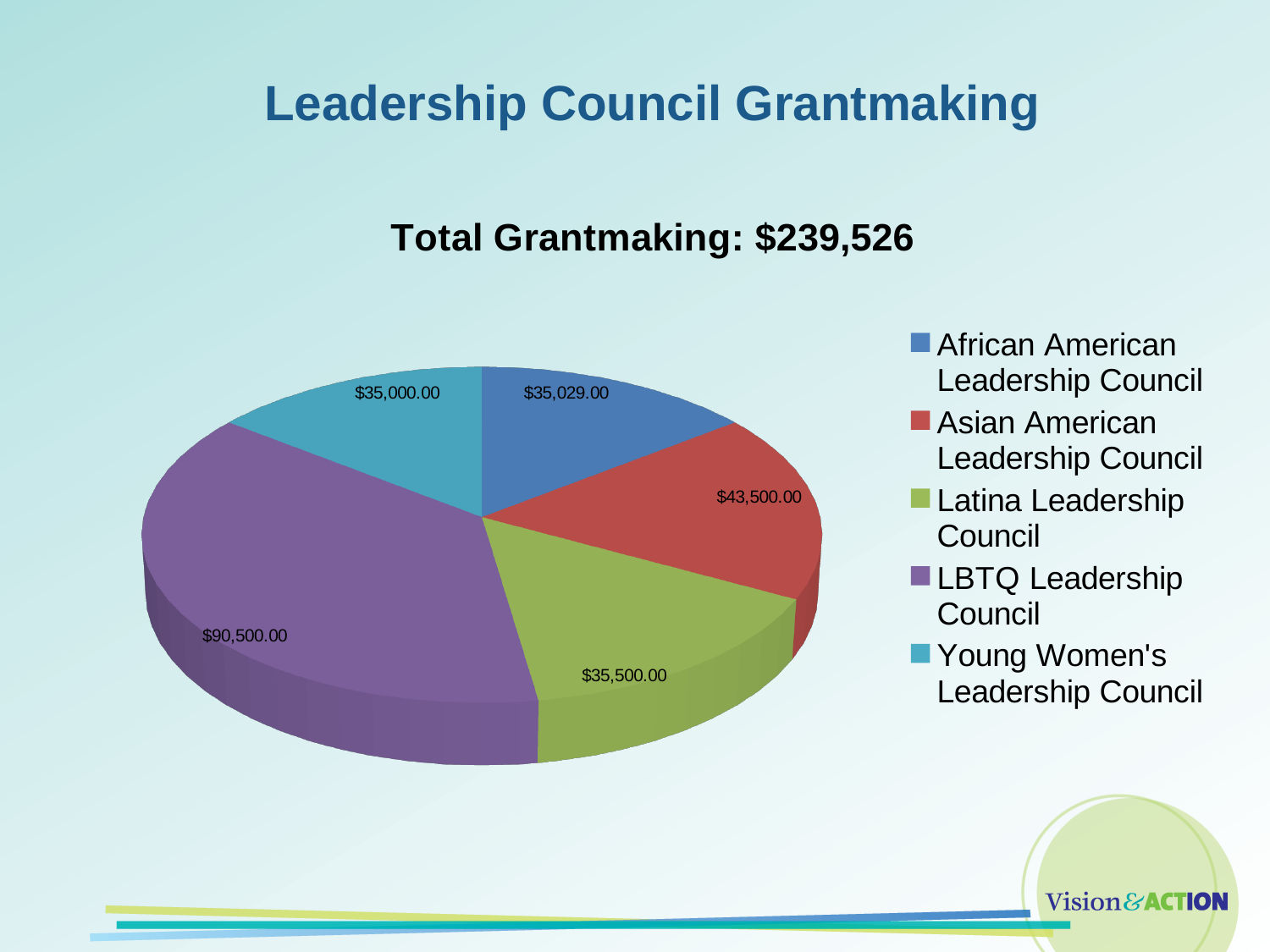
What is the difference between the Asian American Leadership Council and the Latina Leadership Council grantmaking values? $8,000.00 Which council received the smallest amount of grantmaking? Young Women's Leadership Council How many councils are shown in the pie chart? 5 Which received more grantmaking, the Latina Leadership Council or the Asian American Leadership Council? Asian American Leadership Council What is the grantmaking value for the Young Women's Leadership Council? $35,000.00 What total grantmaking amount is stated above the chart? $239,526 What is the grantmaking value for the Asian American Leadership Council? $43,500.00 Which council received the largest share of grantmaking? LBTQ Leadership Council What type of chart is shown on the slide? pie chart How much more grantmaking did the LBTQ Leadership Council receive than the Asian American Leadership Council? $47,000.00 What is the grantmaking value for the African American Leadership Council? $35,029.00 What is the grantmaking value for the LBTQ Leadership Council? $90,500.00